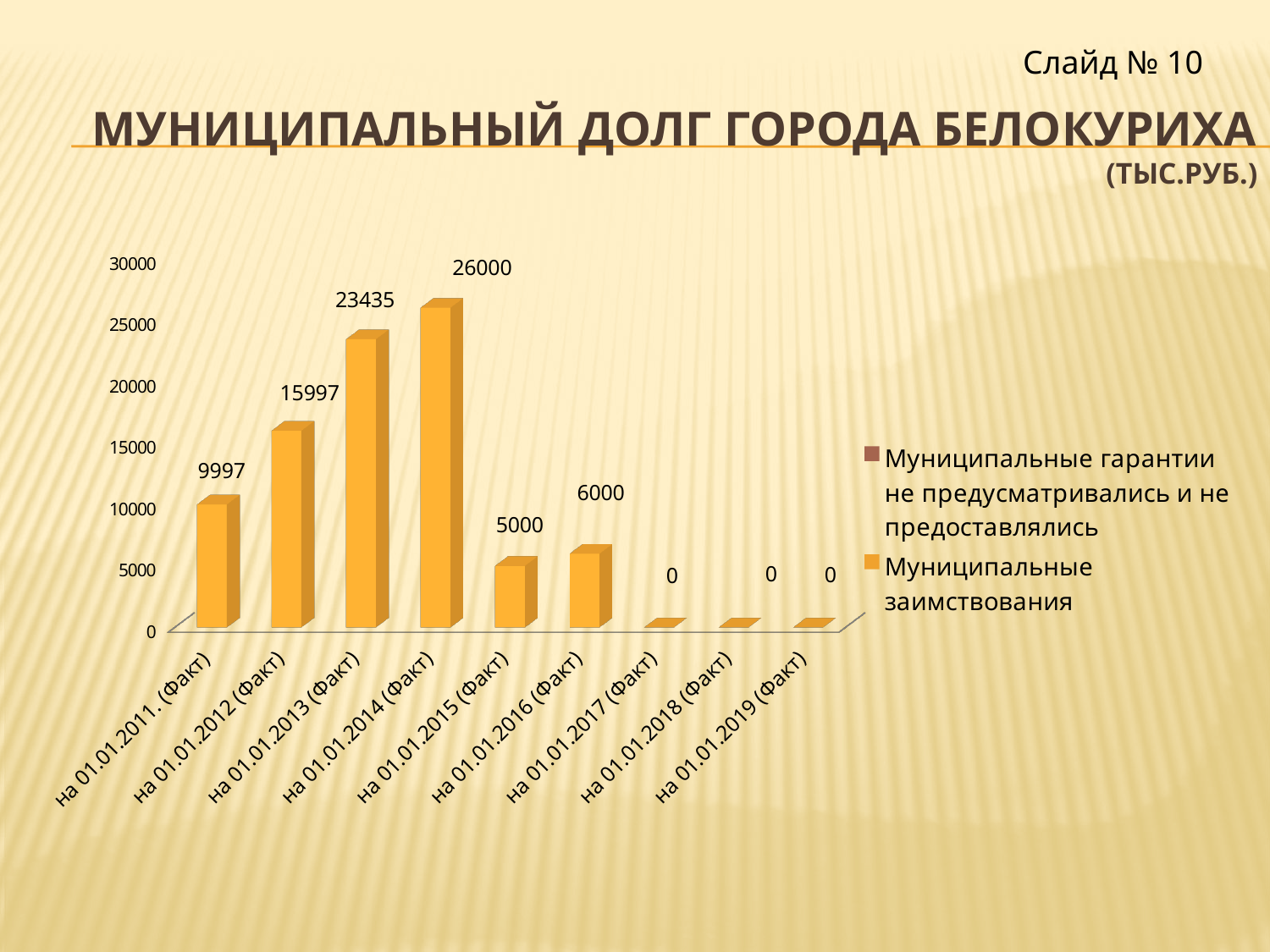
Which date has the highest municipal debt value? на 01.01.2014 (Факт) Which is larger: the value for 01.01.2015 (Факт) or 01.01.2016 (Факт)? 01.01.2016 (Факт) What is the difference between the values for 01.01.2012 (Факт) and 01.01.2011 (Факт)? 6000 What is the value shown for 01.01.2013 (Факт)? 23435 What is the value shown for 01.01.2011 (Факт)? 9997 What is the value shown for 01.01.2016 (Факт)? 6000 What is the difference between the values for 01.01.2014 (Факт) and 01.01.2013 (Факт)? 2565 How many series does the legend list? 2 What is the value shown for 01.01.2017, 01.01.2018 and 01.01.2019 (Факт)? 0 What type of chart is shown on the slide? Bar chart What is the value of municipal borrowings (Муниципальные заимствования) on 01.01.2014 (Факт)? 26000 How many dates (categories) are shown on the x axis? 9